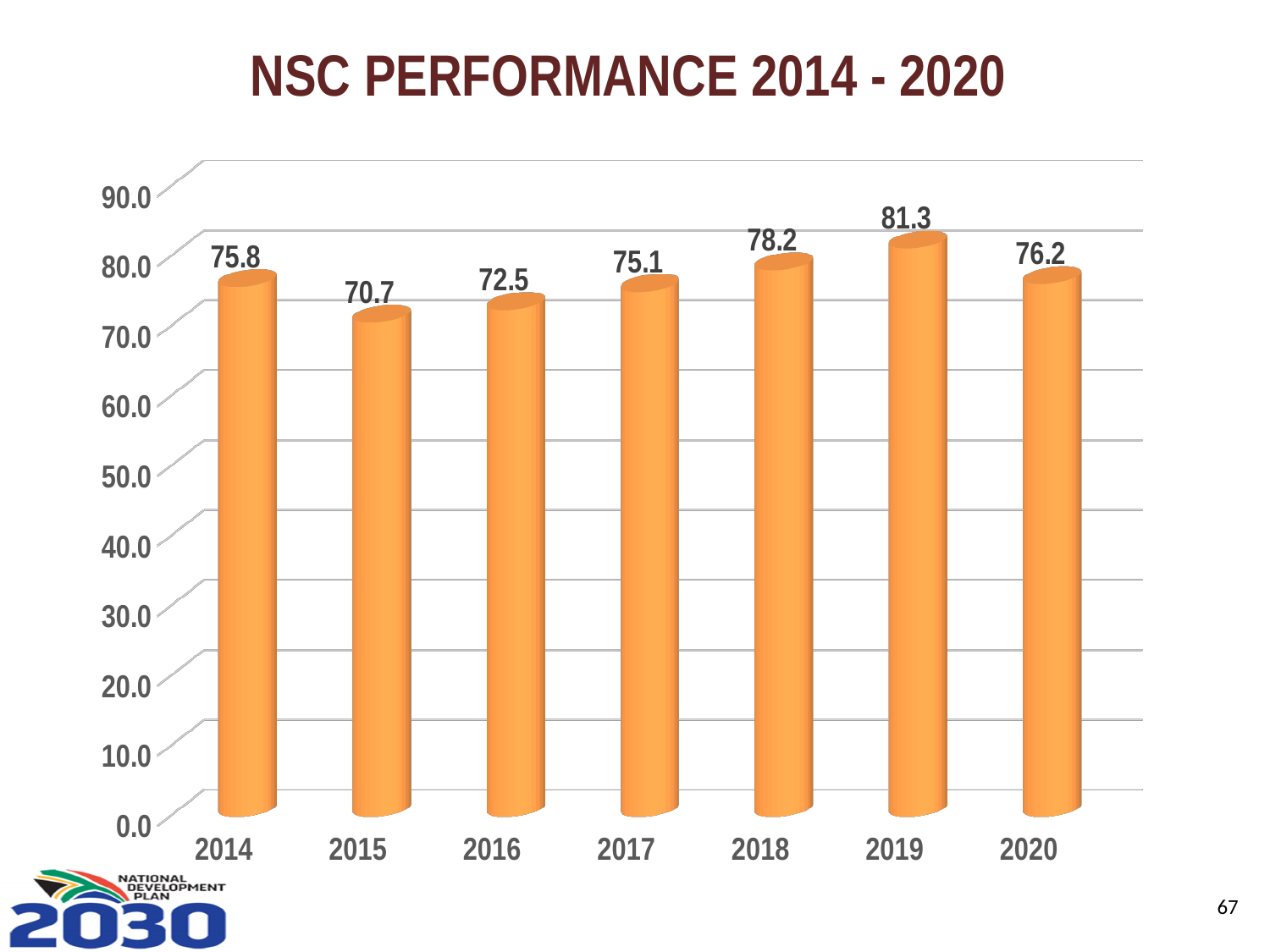
What is the NSC performance value for 2014? 75.8 What is the title of the chart? NSC PERFORMANCE 2014 - 2020 Which year has the highest NSC performance value? 2019 What kind of chart is shown on the slide? Bar chart What is the NSC performance value for 2020? 76.2 Which year has the lowest NSC performance value? 2015 What is the difference between the NSC performance values for 2018 and 2017? 3.1 How many years are shown on the chart? 7 What is the difference between the NSC performance values for 2019 and 2015? 10.6 Is the NSC performance value for 2019 greater or less than 80.0? greater What is the NSC performance value for 2018? 78.2 Which year has a larger NSC performance value, 2016 or 2017? 2017